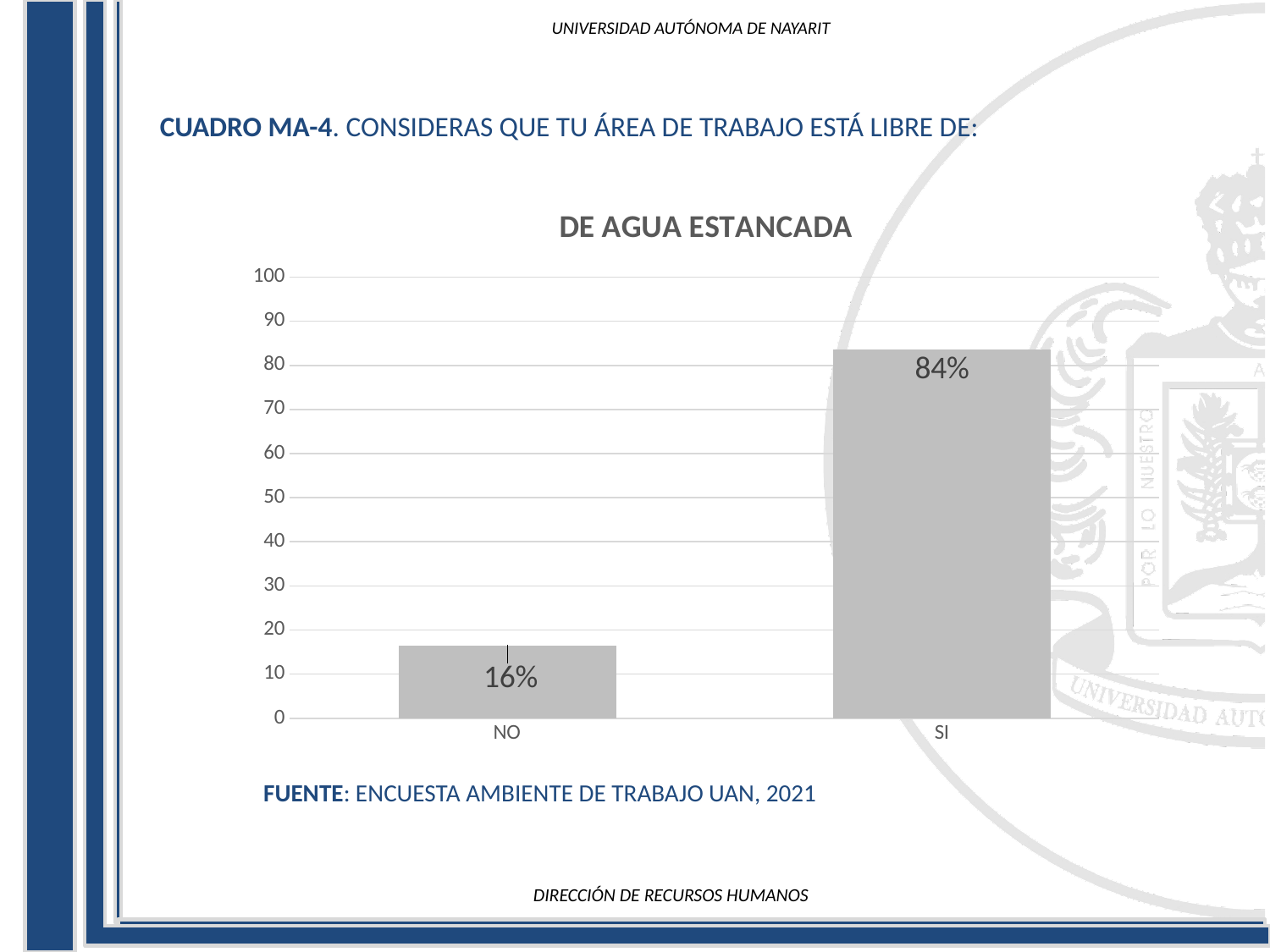
What is the title of the chart? DE AGUA ESTANCADA What is the difference between the values for SI and NO? 68% Is the value for SI greater or less than 80? greater What kind of chart is shown on the slide? bar chart What is the value for NO? 16% Which category has the highest value? SI What is the highest value shown on the y axis? 100 Which is larger, the value for NO or the value for SI? SI How many categories are shown on the x axis? 2 Which category has the lowest value? NO What is the value for SI? 84% Is the value for NO greater or less than 20? less